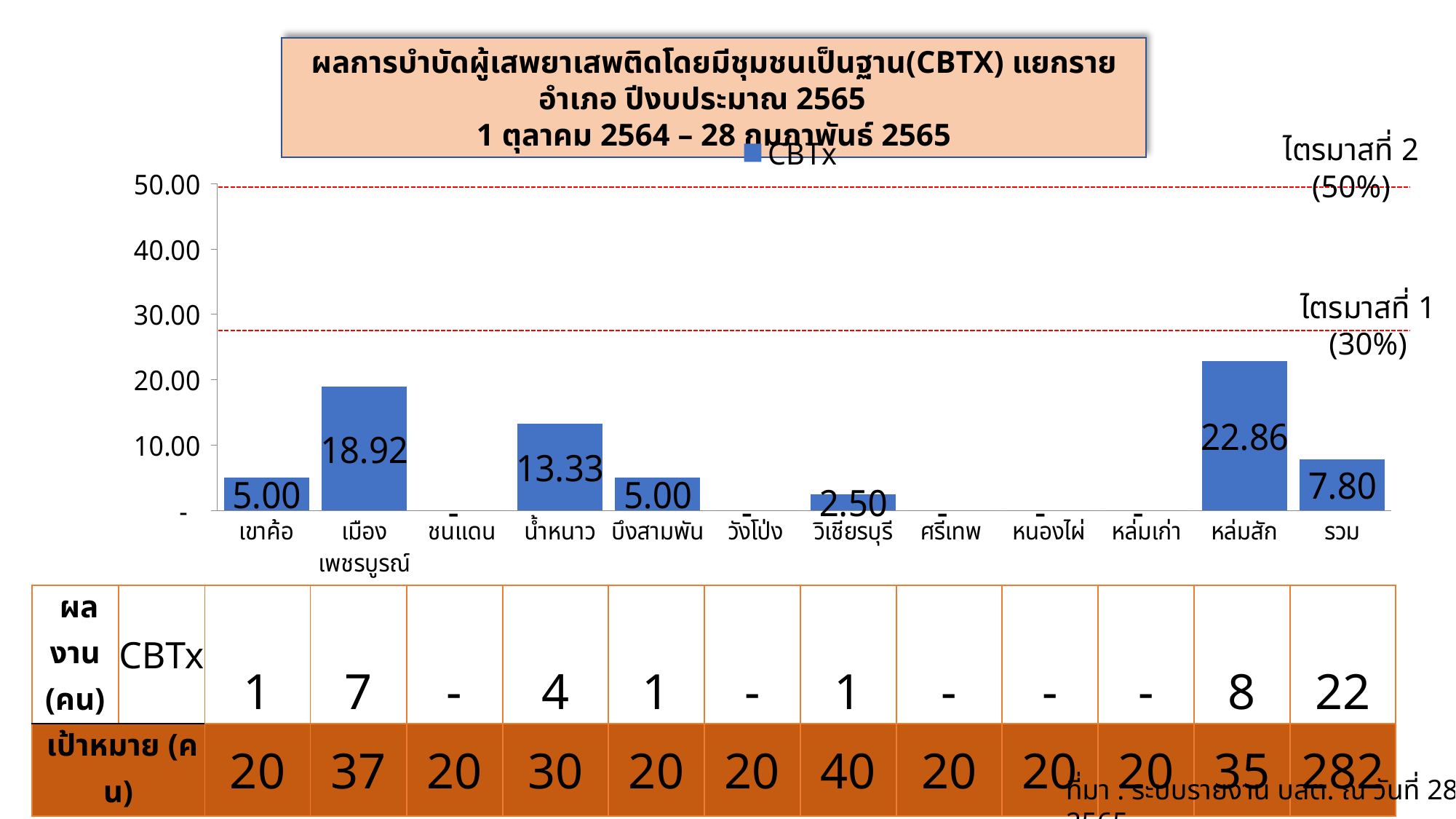
What is the value for หล่มสัก? 22.86 How many categories are shown on the x axis? 12 Is the value for หล่มสัก greater or less than 30.00? less What is the value for น้ำหนาว? 13.33 Which district has the highest bar? หล่มสัก What is the value for รวม? 7.80 What kind of chart is shown? bar chart What is the difference between the values for หล่มสัก and เมืองเพชรบูรณ์? 3.94 Which is larger, the value for น้ำหนาว or the value for รวม? น้ำหนาว What is the value for เมืองเพชรบูรณ์? 18.92 How many series does the legend list? 1 What is the difference between the values for น้ำหนาว and วิเชียรบุรี? 10.83